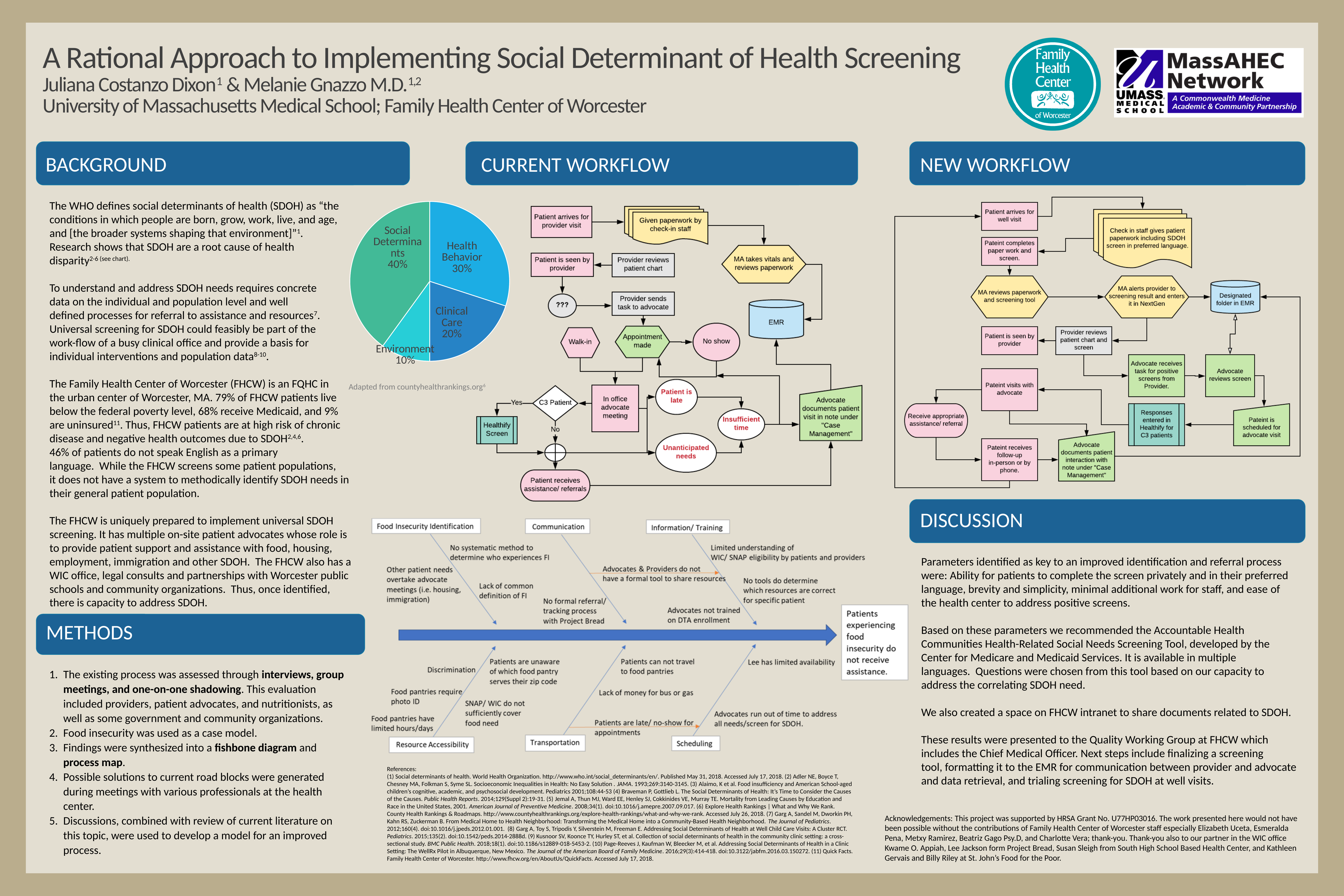
What share of the pie chart is Health Behavior? 30% What kind of chart is shown in the Background section? pie chart What share of the pie chart is Clinical Care? 20% What is the combined share of Health Behavior and Clinical Care in the pie chart? 50% Which is larger in the pie chart, Health Behavior or Environment? Health Behavior What share of the pie chart is Environment? 10% What share of the pie chart is Social Determinants? 40% What is the difference in percentage points between Social Determinants and Clinical Care in the pie chart? 20 Which slice of the pie chart is the largest? Social Determinants Which slice of the pie chart is the smallest? Environment How many slices does the pie chart have? 4 According to the note under the pie chart, what source was it adapted from? countyhealthrankings.org